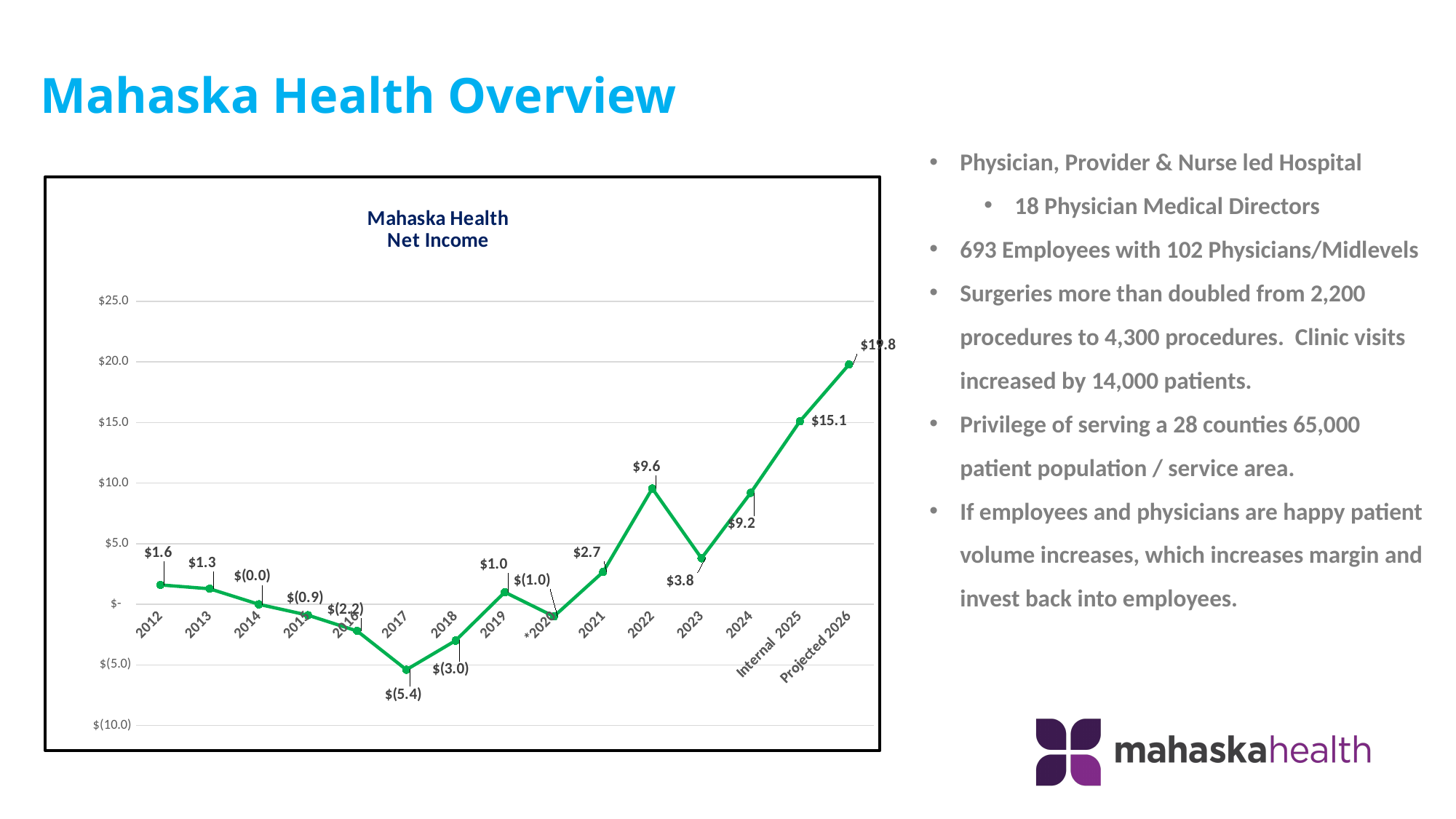
Which is larger, the net income for 2021 or for 2024? 2024 What is the net income value for 2012? $1.6 What is the difference between the net income for 2022 and 2023? $5.8 What is the net income value for Internal 2025? $15.1 What is the net income value for 2022? $9.6 Does net income rise or fall from 2012 to 2017? fall What is the net income value for 2017? $(5.4) What is the title of the chart? Mahaska Health Net Income Which year has the lowest net income? 2017 How many data points are plotted on the line? 15 Which category has the highest net income? Projected 2026 What kind of chart is shown on the slide? line chart